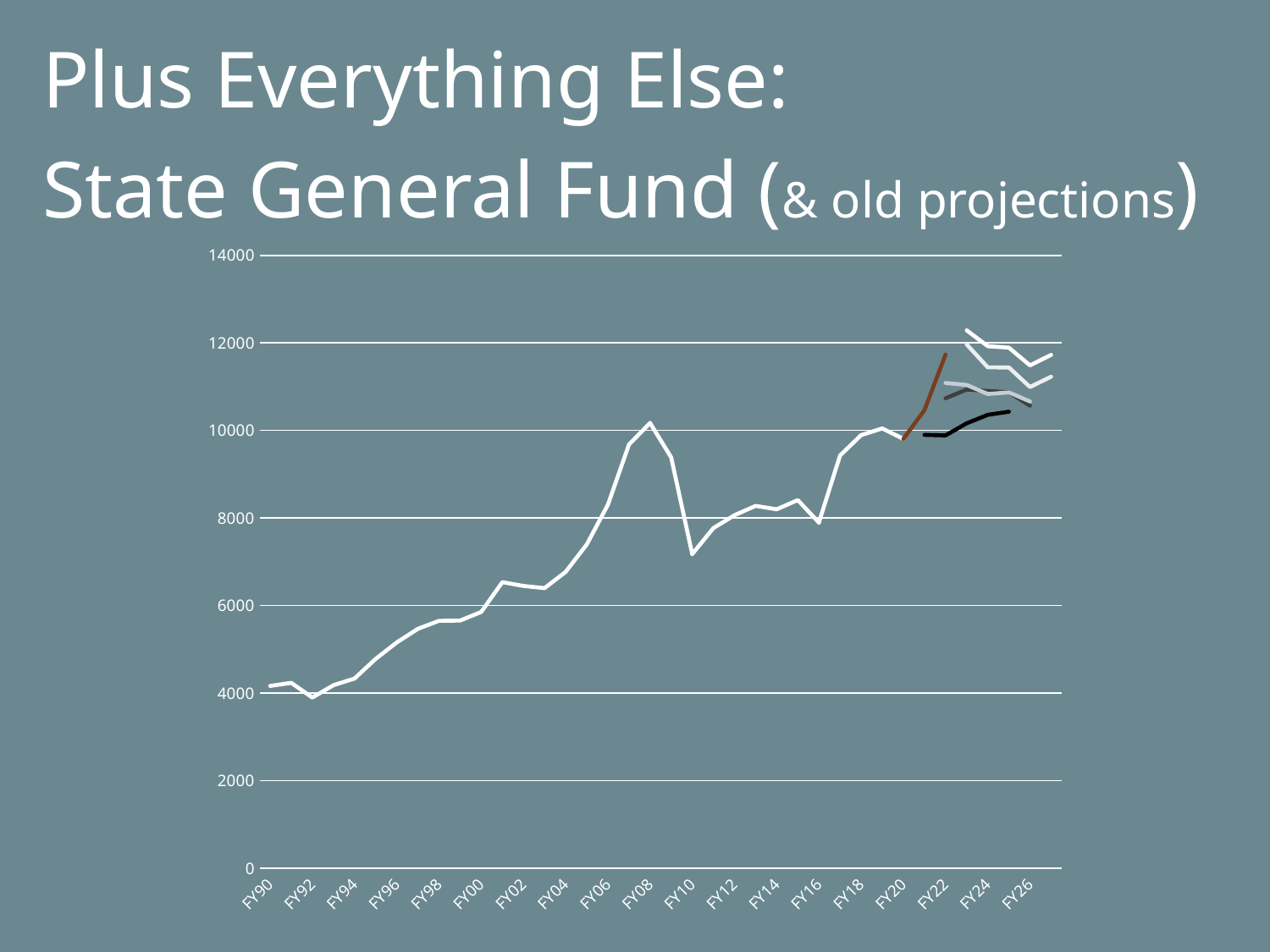
Is the value of the State General Fund for FY04 greater or less than 6000? greater Is the value of the State General Fund for FY06 greater or less than 8000? greater Does the State General Fund line generally rise or fall from FY90 to FY20? rise Around which fiscal year does the main white line reach its lowest point? FY92 Is the value of the State General Fund for FY18 greater or less than 12000? less Around which fiscal year does the main white line reach its highest point before FY10? FY08 What kind of chart is shown on the slide? line chart What is the highest value shown on the vertical axis? 14000 What is the first fiscal year label on the horizontal axis? FY90